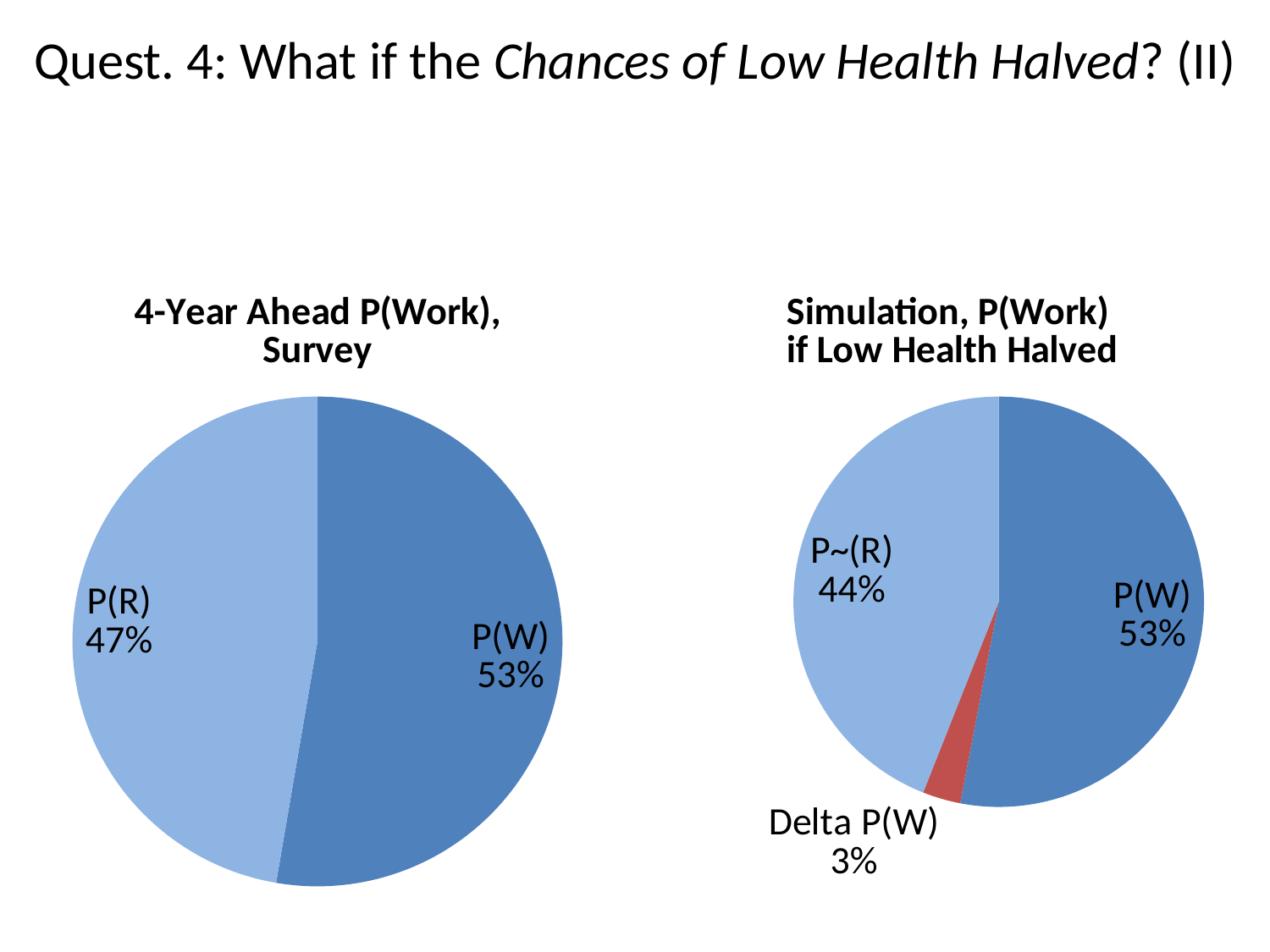
What type of chart is the '4-Year Ahead P(Work), Survey' chart? Pie chart In the '4-Year Ahead P(Work), Survey' chart, which slice is larger, P(W) or P(R)? P(W) In the 'Simulation, P(Work) if Low Health Halved' chart, which slice is the largest? P(W) In the 'Simulation, P(Work) if Low Health Halved' chart, which slice is the smallest? Delta P(W) In the '4-Year Ahead P(Work), Survey' chart, what share does P(W) have? 53% In the 'Simulation, P(Work) if Low Health Halved' chart, what is the difference between the P(W) and P~(R) shares? 9% In the 'Simulation, P(Work) if Low Health Halved' chart, what share does Delta P(W) have? 3% In the '4-Year Ahead P(Work), Survey' chart, what share does P(R) have? 47% In the 'Simulation, P(Work) if Low Health Halved' chart, what share does P~(R) have? 44% In the '4-Year Ahead P(Work), Survey' chart, what is the difference between the P(W) and P(R) shares? 6% In the 'Simulation, P(Work) if Low Health Halved' chart, what colour is the Delta P(W) slice? Red How many slices does the 'Simulation, P(Work) if Low Health Halved' chart have? 3